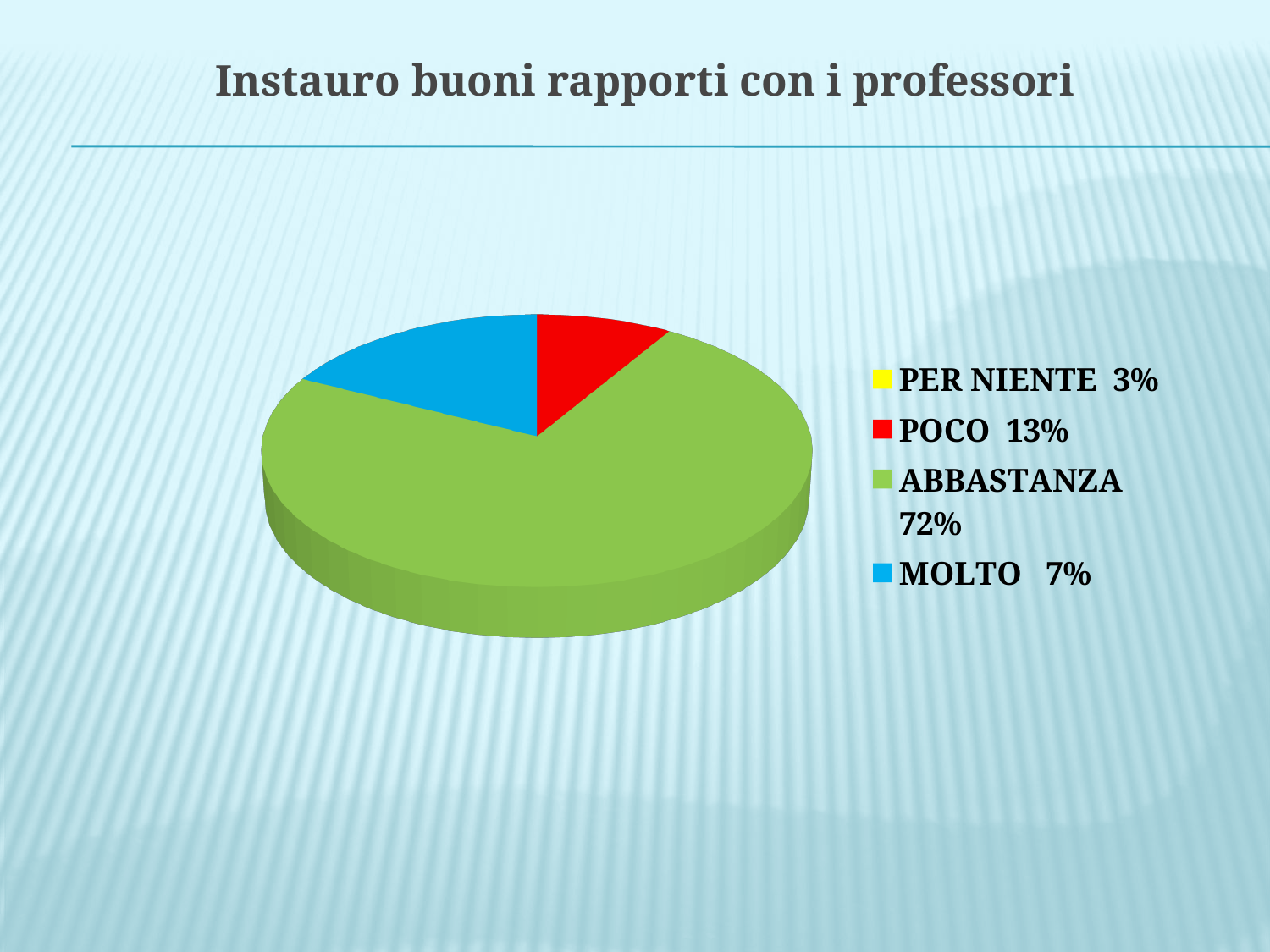
What percentage is shown for POCO? 13% What percentage is shown for MOLTO? 7% Which category has the smallest percentage in the legend? PER NIENTE Which is larger, the share for ABBASTANZA or the share for POCO? ABBASTANZA What is the title of the slide? Instauro buoni rapporti con i professori What percentage is shown for ABBASTANZA? 72% What is the difference in percentage points between ABBASTANZA and POCO? 59 What percentage is shown for PER NIENTE? 3% What colour represents ABBASTANZA in the pie chart? Green What kind of chart is shown on the slide? Pie chart Which category has the largest share of the pie? ABBASTANZA How many categories does the pie chart have? 4